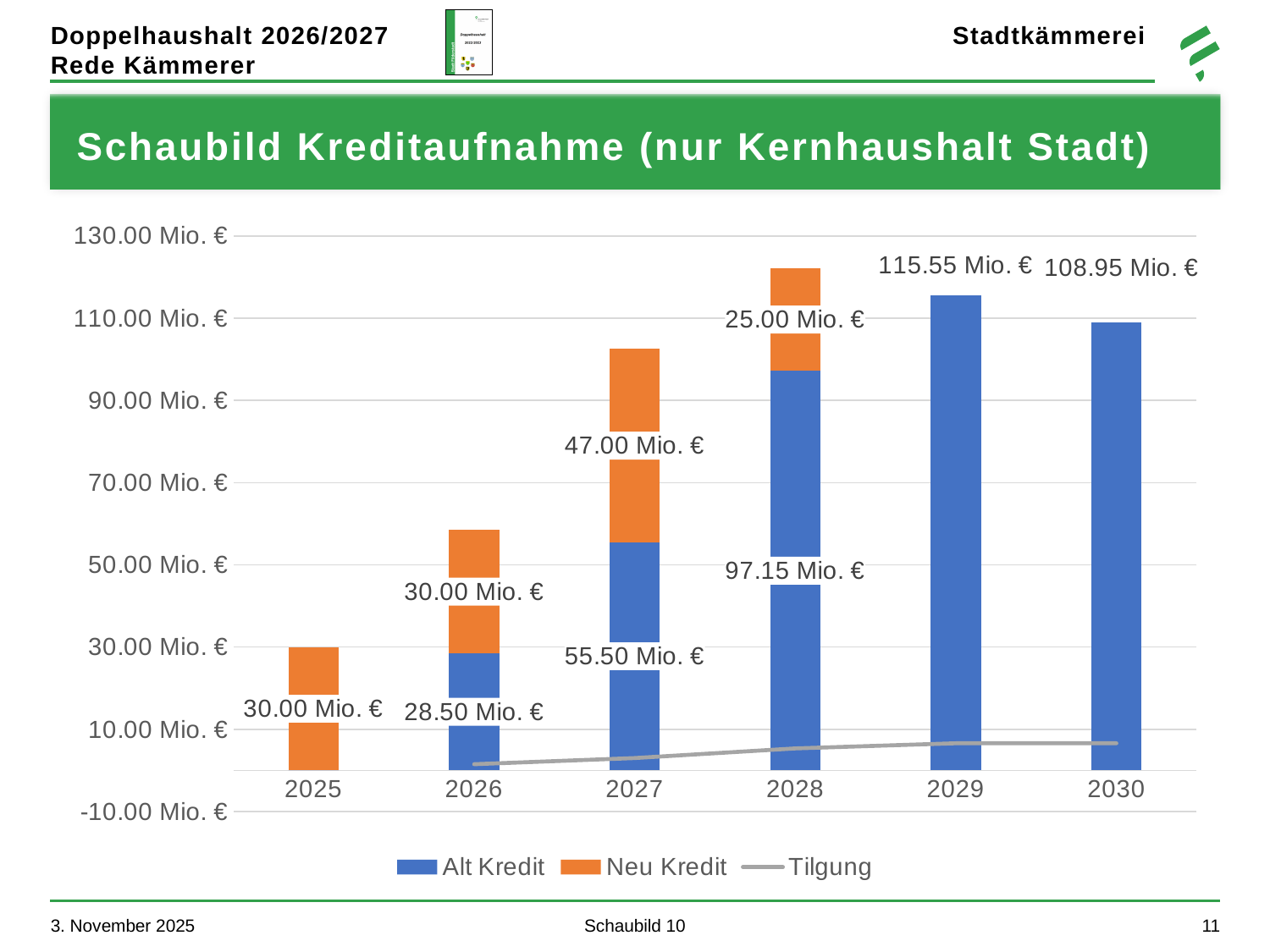
In which year is the Alt Kredit value highest? 2029 What is the difference between the Alt Kredit values for 2029 and 2030? 6.60 Mio. € What is the Alt Kredit value for 2029? 115.55 Mio. € In 2027, which is larger: Alt Kredit or Neu Kredit? Alt Kredit Among the years with a Neu Kredit segment, which year has the lowest Neu Kredit value? 2028 How many series does the legend list? 3 What is the total of the stacked bar for 2027 (Alt Kredit plus Neu Kredit)? 102.50 Mio. € What is the Neu Kredit value for 2027? 47.00 Mio. € How many years are shown on the x axis? 6 What is the Neu Kredit value for 2025? 30.00 Mio. € What is the Alt Kredit value for 2028? 97.15 Mio. € Is the Tilgung value for 2030 greater or less than 10.00 Mio. €? less